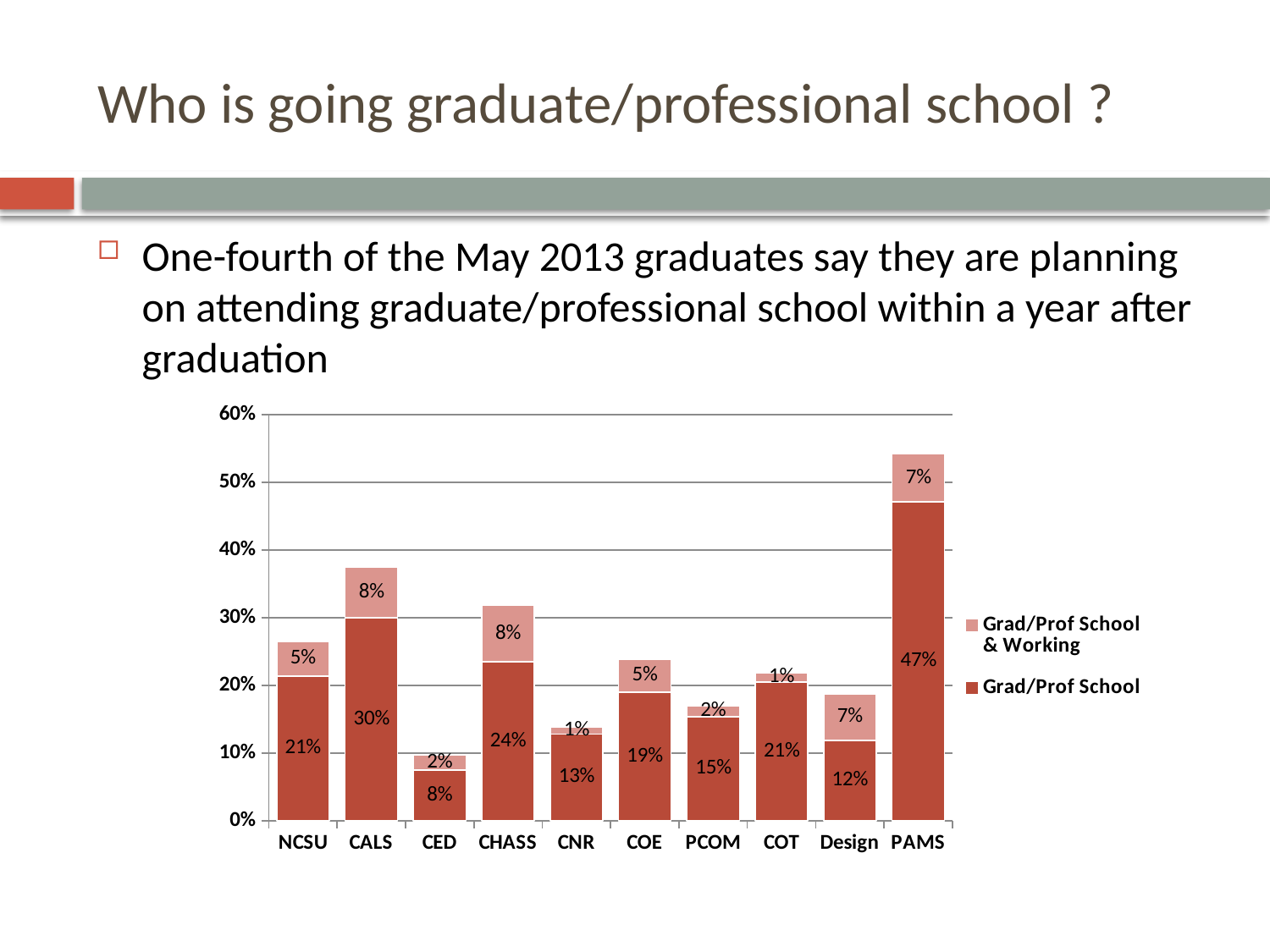
What is the total of the stacked bar for CALS? 38% Which is larger, the Grad/Prof School value for NCSU or for PCOM? NCSU What kind of chart is shown on the slide? Stacked bar chart What is the difference between the Grad/Prof School values for CALS and COE? 11% What is the Grad/Prof School value for PAMS? 47% What is the total of the stacked bar for PAMS? 54% What is the Grad/Prof School & Working value for CHASS? 8% What is the Grad/Prof School value for Design? 12% Which category has the highest Grad/Prof School value? PAMS Which category has the lowest Grad/Prof School value? CED How many series does the legend list? 2 How many categories are shown on the x axis? 10